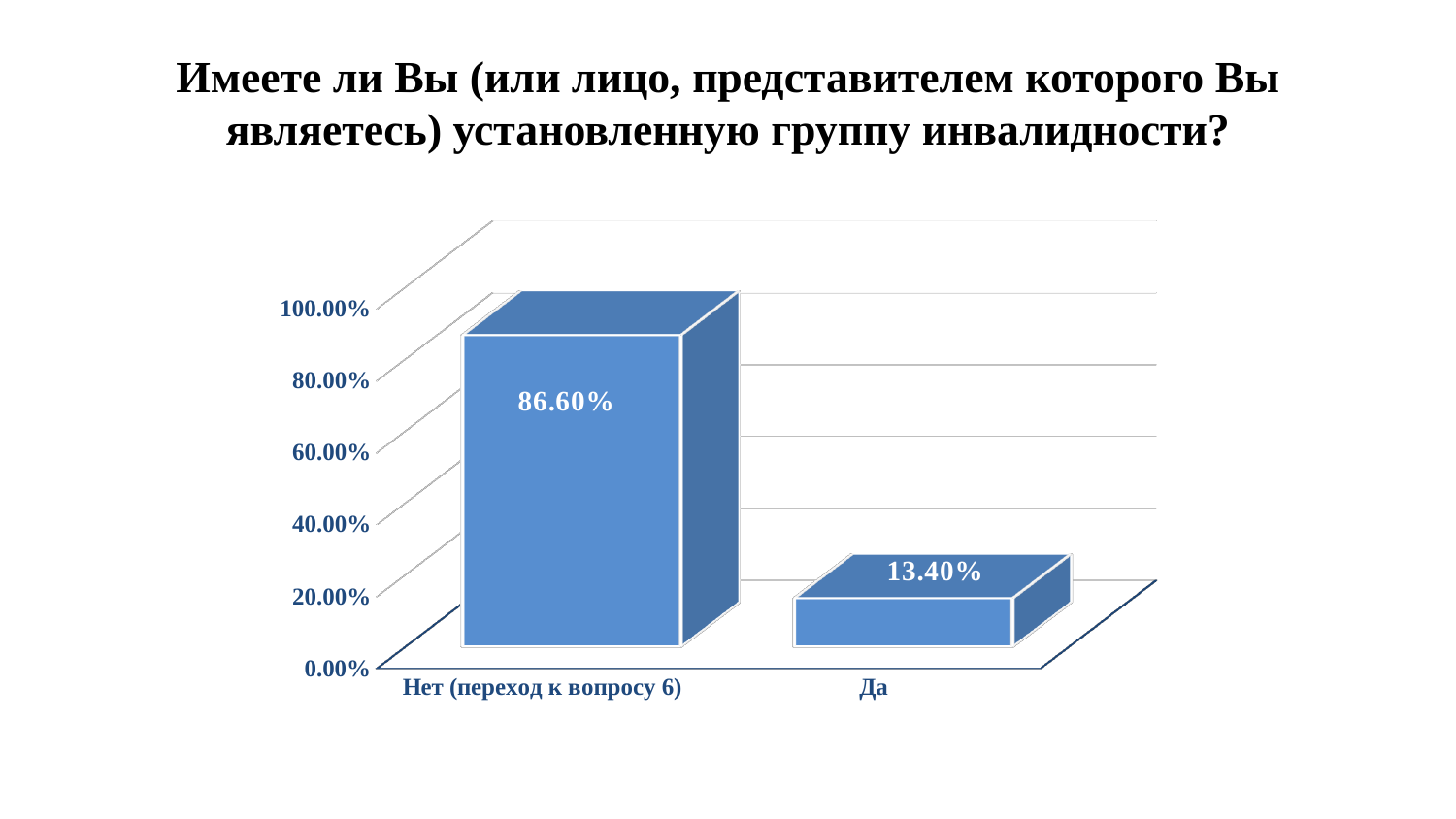
How many categories are shown in the chart? 2 What is the difference between the values for "Нет (переход к вопросу 6)" and "Да"? 73.20% Which is larger, the value for "Да" or the value for "Нет (переход к вопросу 6)"? Нет (переход к вопросу 6) Is the value for "Нет (переход к вопросу 6)" greater or less than 80.00%? greater What is the title of the slide above the chart? Имеете ли Вы (или лицо, представителем которого Вы являетесь) установленную группу инвалидности? What is the total of the two values shown in the chart? 100.00% What kind of chart is shown on the slide? bar chart Is the value for "Да" greater or less than 20.00%? less What is the value for "Нет (переход к вопросу 6)"? 86.60% Which category has the lowest value? Да What is the value for "Да"? 13.40% Which category has the highest value? Нет (переход к вопросу 6)